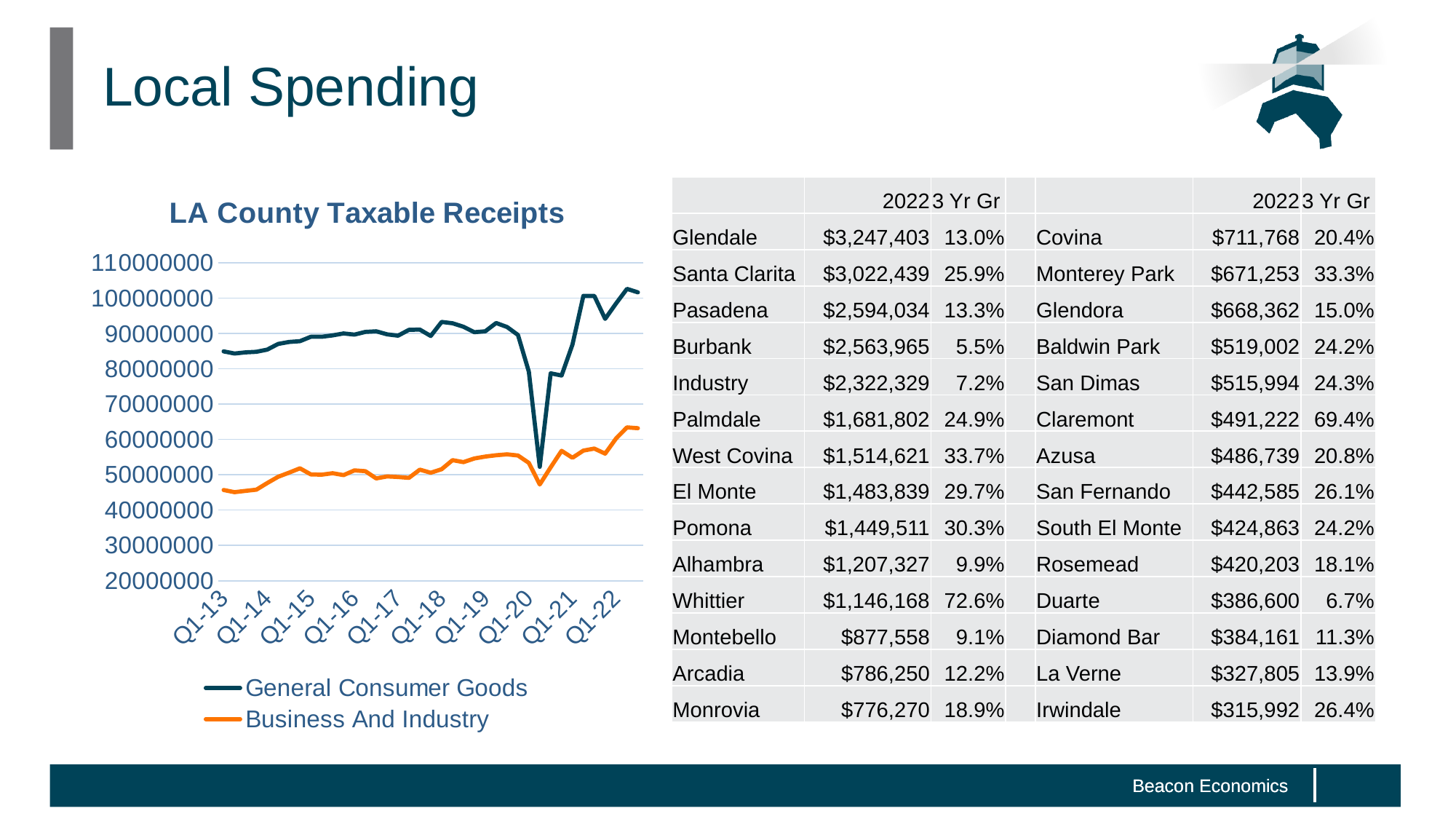
Is the value for General Consumer Goods at Q1-22 greater or less than 90000000? greater Is the value for Business And Industry at Q1-13 greater or less than 50000000? less Which series has the higher value at Q1-20, General Consumer Goods or Business And Industry? General Consumer Goods Which series in the chart is drawn in orange? Business And Industry What kind of chart is shown on the slide? line chart Is the value for General Consumer Goods at Q1-13 greater or less than 80000000? greater How many series does the legend of the LA County Taxable Receipts chart list? 2 What is the title of the chart on the slide? LA County Taxable Receipts Does the Business And Industry line rise or fall overall from Q1-13 to Q1-22? rise Which series reaches the highest value on the chart? General Consumer Goods